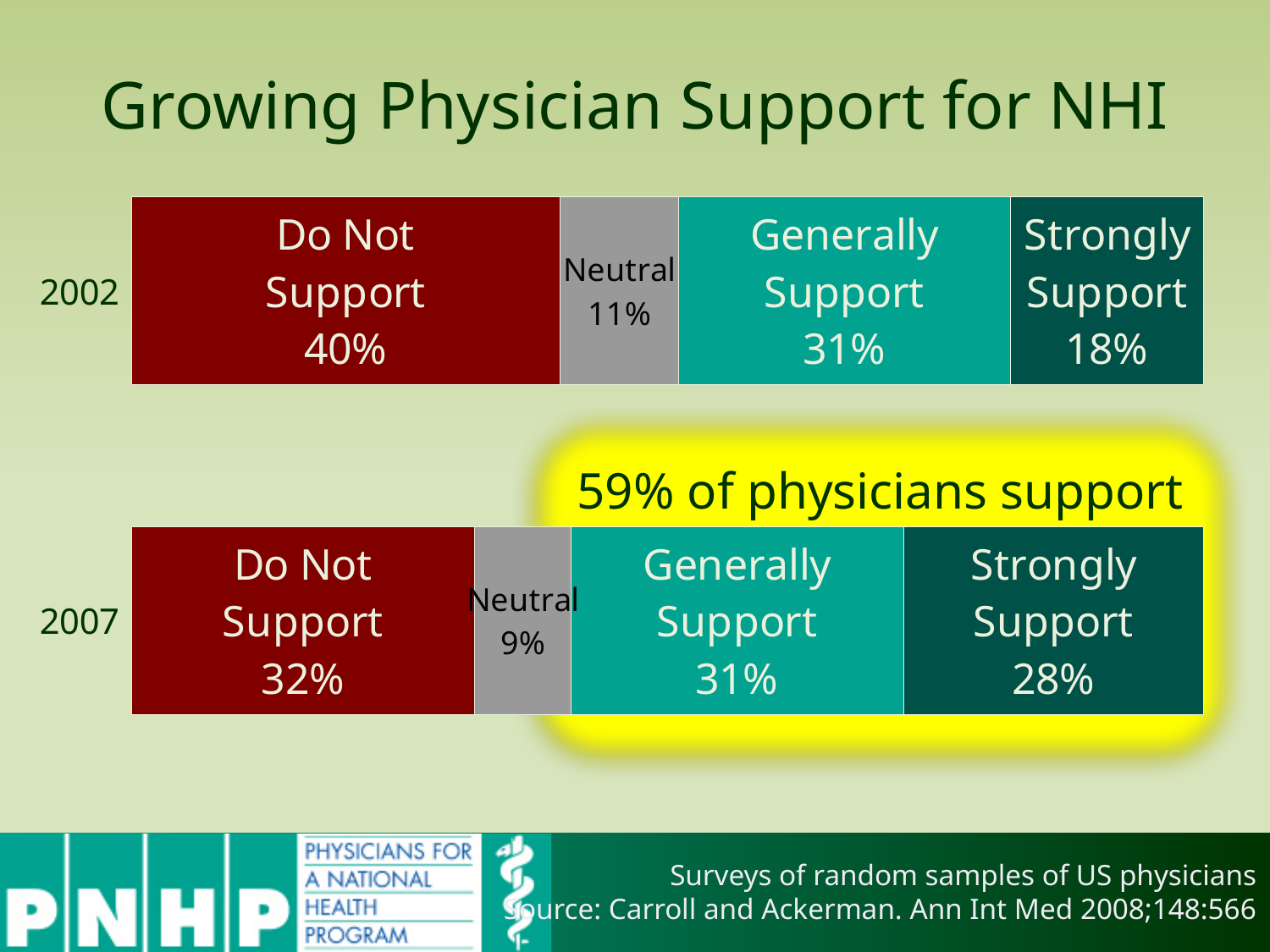
What percentage of physicians did not support NHI in 2002? 40% What type of chart is shown on the slide? Stacked bar chart Which response category had the smallest share in 2007? Neutral What was the Generally Support share in 2002? 31% What is the combined share of Generally Support and Strongly Support in 2007? 59% Which response category had the largest share in 2002? Do Not Support By how many percentage points did Strongly Support increase from 2002 to 2007? 10 percentage points By how many percentage points did Do Not Support fall from 2002 to 2007? 8 percentage points In 2007, which was larger: Generally Support or Strongly Support? Generally Support What percentage of physicians strongly supported NHI in 2007? 28% How many response categories are shown in each bar? 4 What was the Neutral share in 2007? 9%